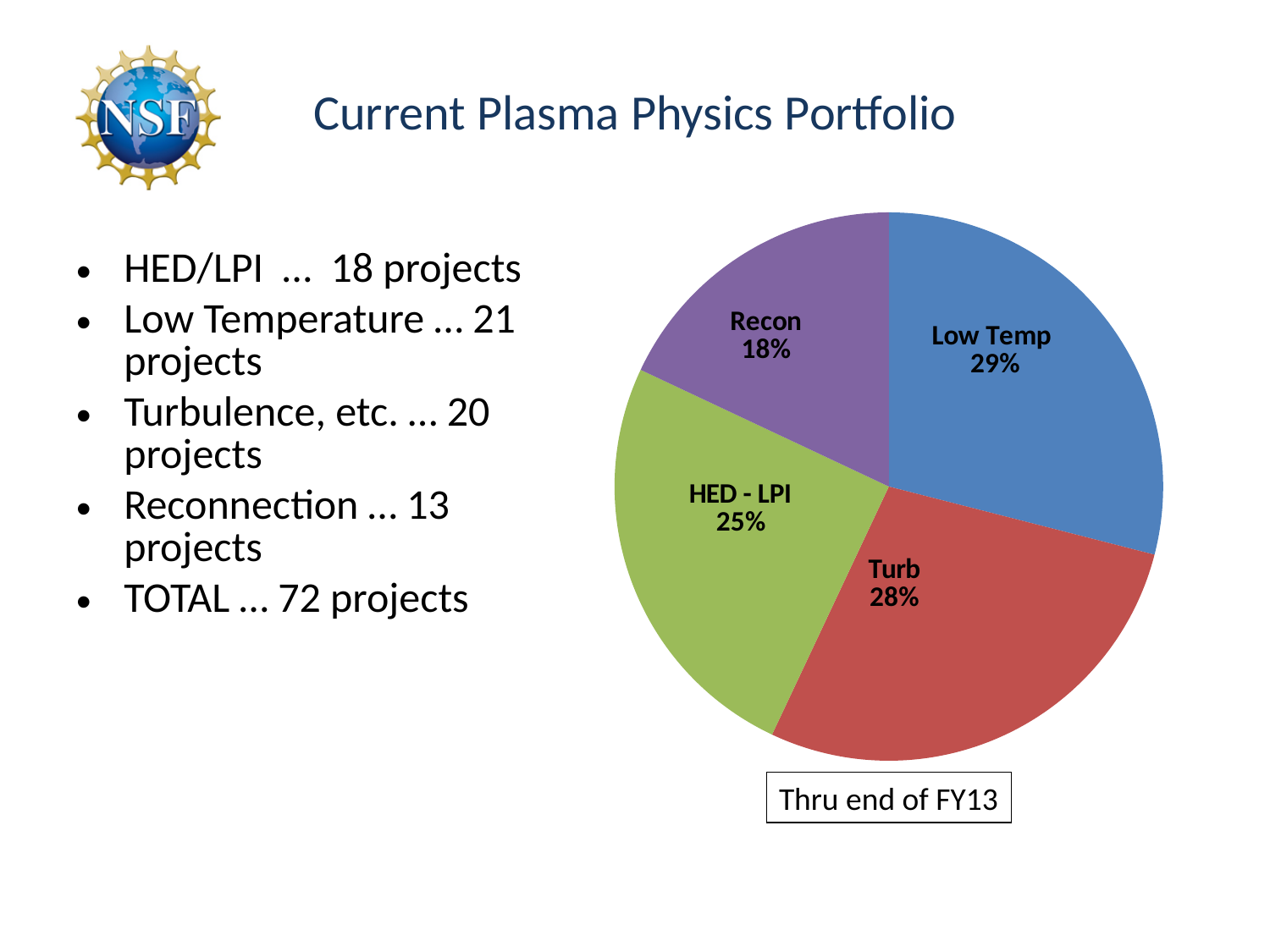
How many slices does the pie chart have? 4 What percentage share does the Low Temp slice have? 29% What kind of chart is shown on the slide? pie chart What colour is the Turb slice in the pie chart? red Which slice of the pie chart is the largest? Low Temp What is the difference in percentage points between the Turb and HED - LPI slices? 3 What is the difference in percentage points between the Low Temp and Recon slices? 11 What percentage share does the Turb slice have? 28% Which slice of the pie chart is the smallest? Recon What percentage share does the HED - LPI slice have? 25% Which slice is larger, HED - LPI or Recon? HED - LPI